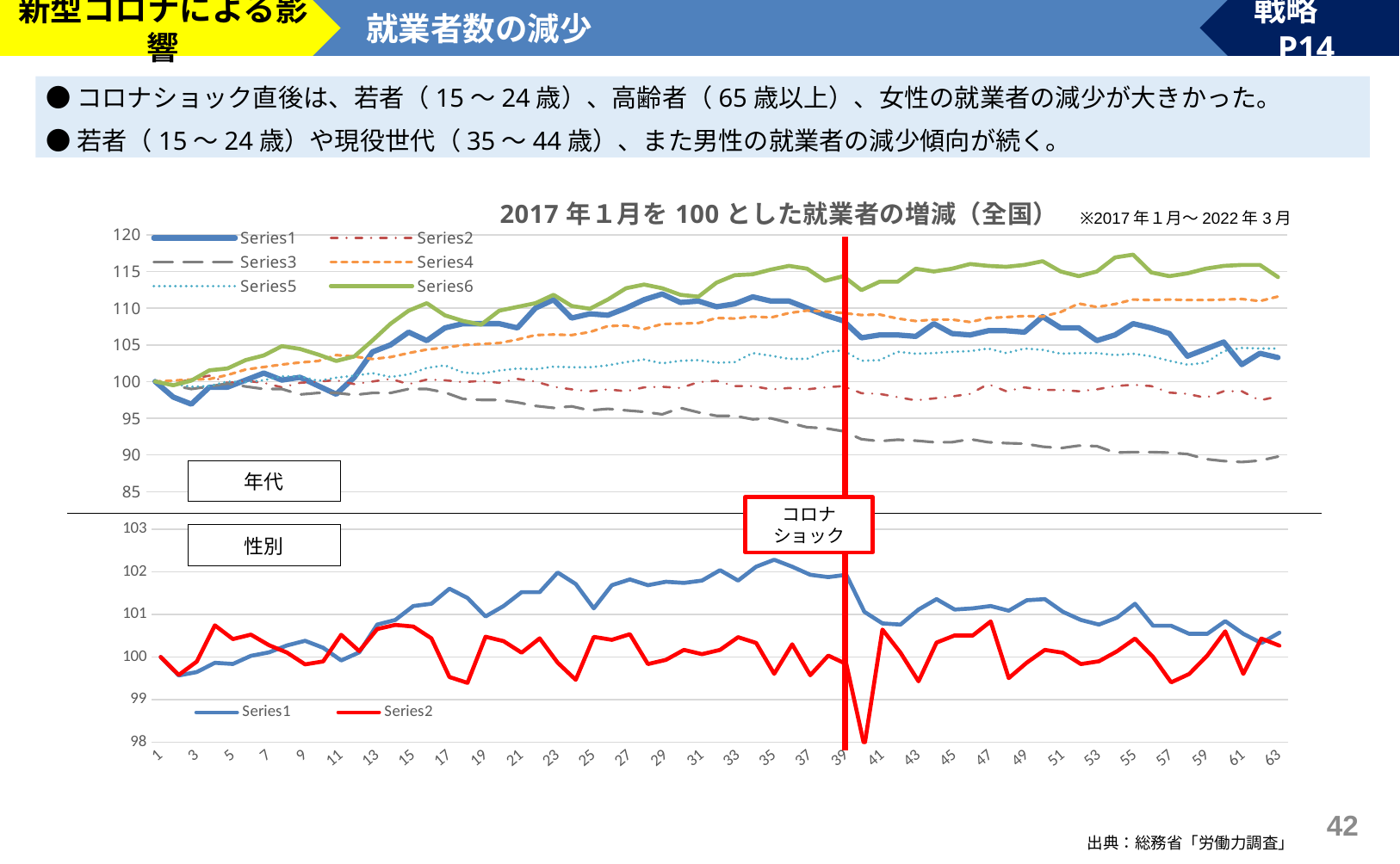
In the upper chart (年代), does Series3 generally rise or fall along the x axis? fall In the upper chart (年代), is the value of Series6 at point 63 greater or less than 110? greater In the lower chart (性別), at point 35, which series has the larger value, Series1 or Series2? Series1 In the upper chart (年代), which series has the highest value at the last point (63)? Series6 What is the title shown above the upper chart? 2017年1月を100とした就業者の増減（全国） In the upper chart (年代), which series has the lowest value at the last point (63)? Series3 What kind of chart is the upper chart labelled 年代? line chart How many series does the legend of the upper chart (年代) list? 6 What label is attached to the red vertical line that crosses both charts? コロナショック In the lower chart (性別), is the value of Series2 at point 40 greater or less than 99? less In the upper chart (年代), is the value of Series3 at point 63 greater or less than 95? less How many series does the legend of the lower chart (性別) list? 2